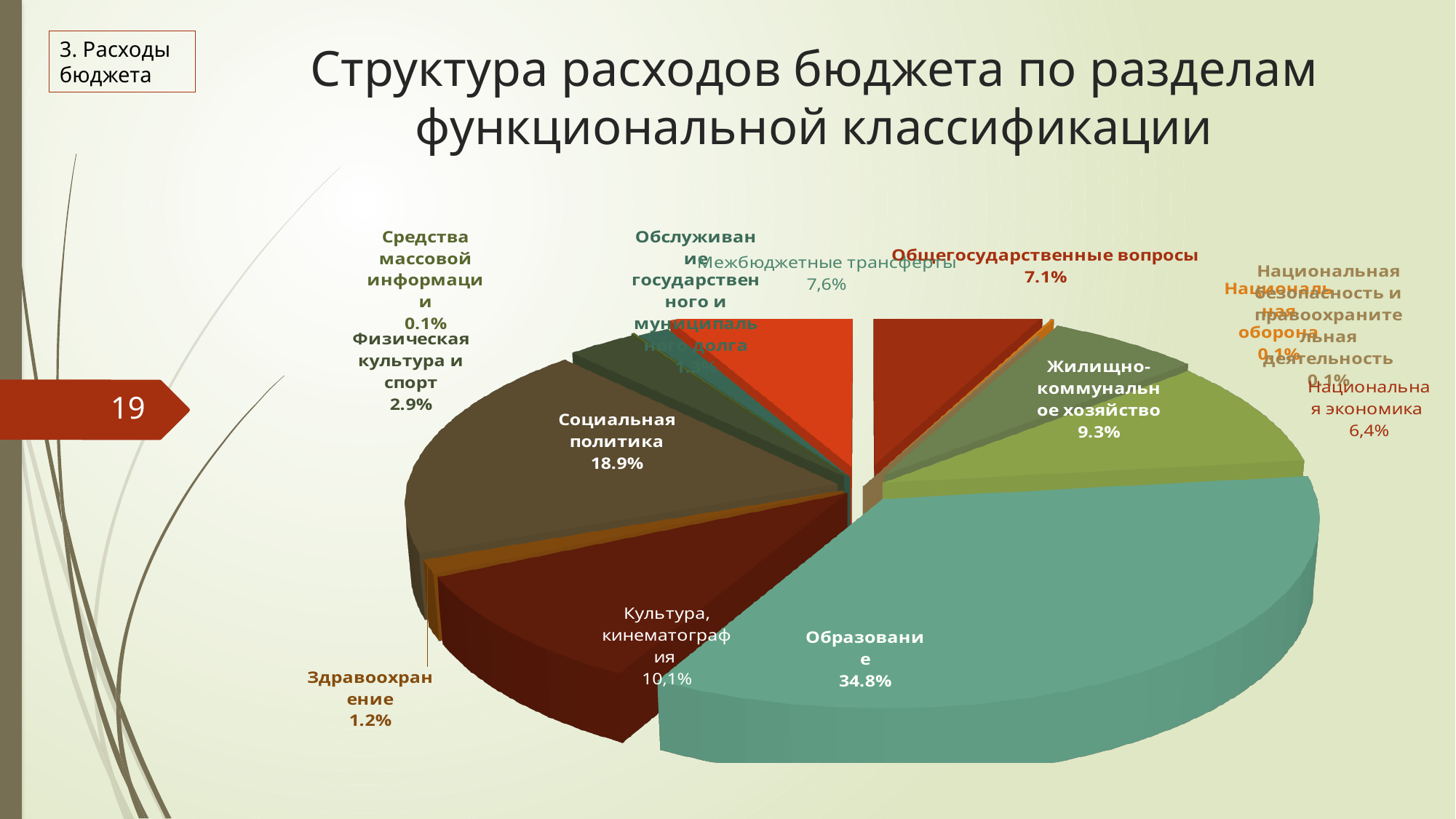
What is the value shown for Здравоохранение? 1.2% What is the value shown for Жилищно-коммунальное хозяйство? 9.3% What is the value shown for Национальная экономика? 6,4% What is the title of the chart on the slide? Структура расходов бюджета по разделам функциональной классификации Which is larger: the share for Общегосударственные вопросы or for Жилищно-коммунальное хозяйство? Жилищно-коммунальное хозяйство What type of chart is shown on the slide? pie chart What is the difference between the shares of Образование and Социальная политика? 15.9% Which section has the largest share of budget expenditure? Образование What is the value shown for Социальная политика? 18.9% What share of budget expenditure goes to Образование? 34.8% What is the difference between the shares of Культура, кинематография and Физическая культура и спорт? 7.2% What is the value shown for Межбюджетные трансферты? 7,6%